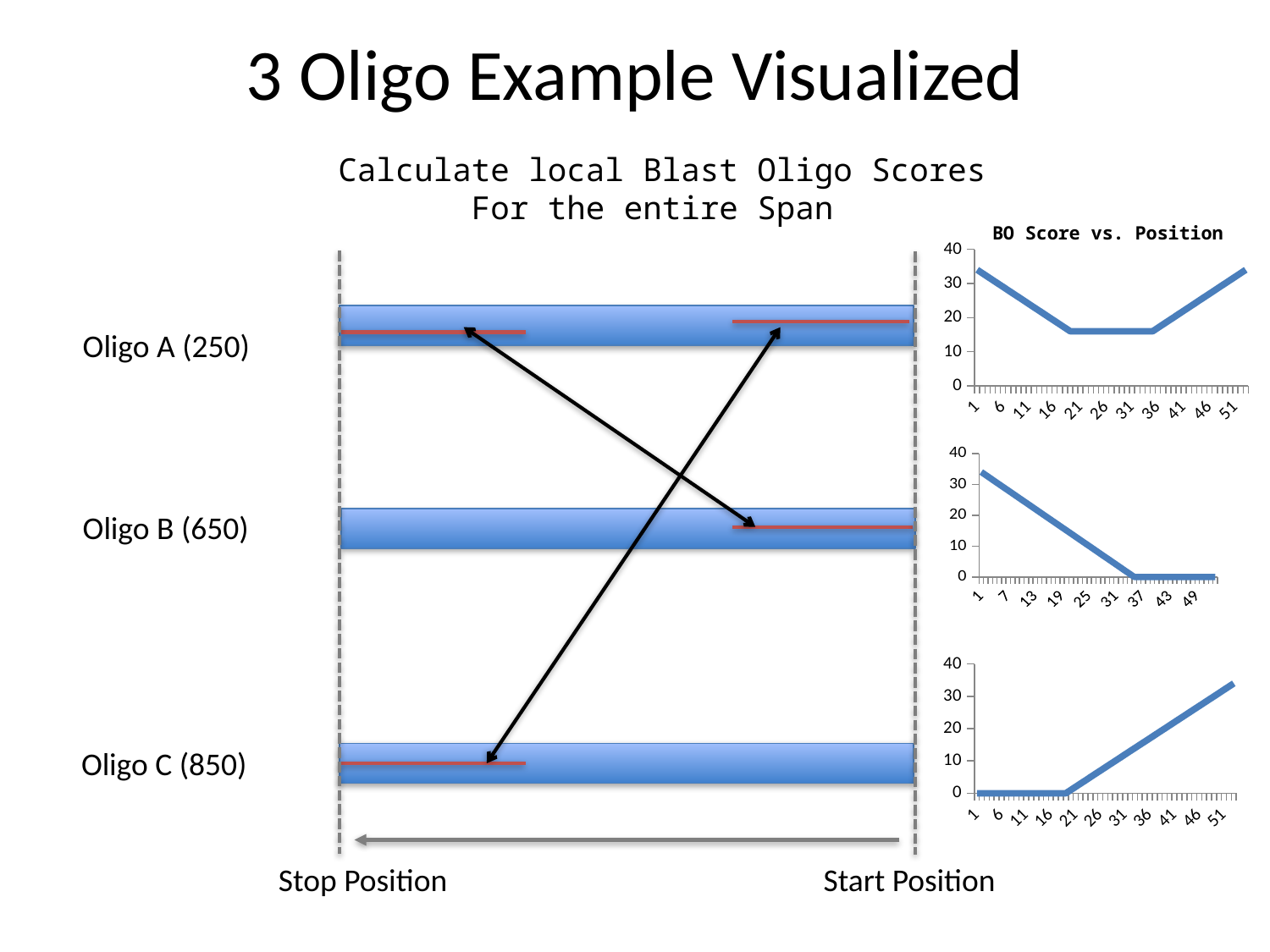
In the top chart 'BO Score vs. Position', is the value at position 1 greater or less than 30? greater In the top chart 'BO Score vs. Position', is the value at position 26 greater or less than 20? less In the top chart 'BO Score vs. Position', does the line fall, rise, or fall and then rise along the x axis? falls then rises In the bottom chart on the right, is the value at the last plotted position greater or less than 30? greater In the middle chart on the right, what is the value at position 49? 0 In the middle chart on the right, does the value rise or fall from position 1 to position 37? fall In the bottom chart on the right, what is the value at position 11? 0 How many charts are shown on the right side of the slide? 3 In the bottom chart on the right, does the value rise or fall from position 21 to the end of the x axis? rise What kind of chart is the top chart on the right, titled 'BO Score vs. Position'? line chart What is the title of the top chart on the right? BO Score vs. Position